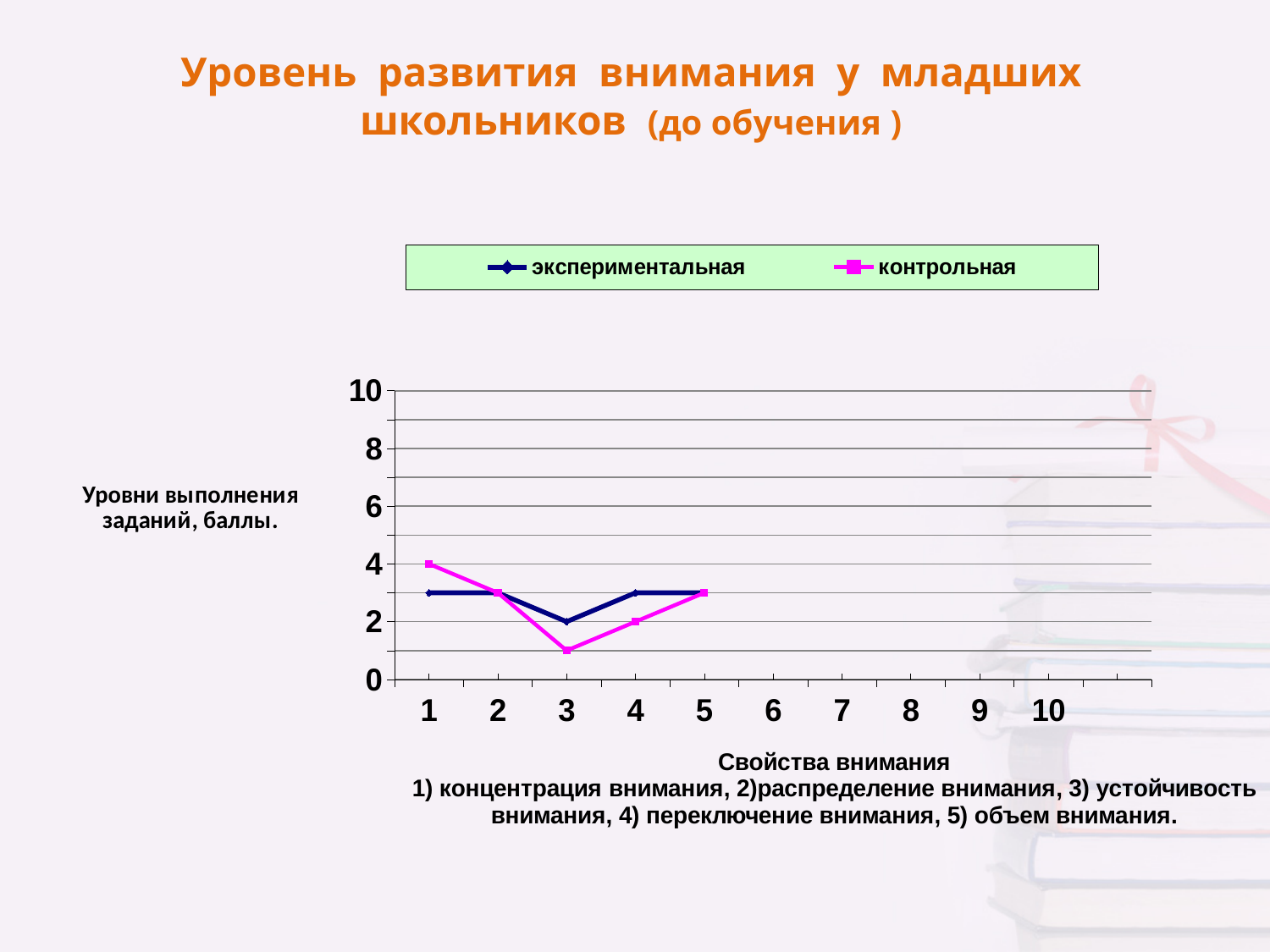
What is the value of the экспериментальная series at category 3? 2 What is the difference between the контрольная value at category 1 and the экспериментальная value at category 3? 2 What kind of chart is shown on the slide? line chart Does the контрольная series rise or fall from category 3 to category 5? rise At which category does the контрольная series reach its lowest value? 3 Is the value of the экспериментальная series at category 1 greater or less than 2? greater What is the value of the контрольная series at category 4? 2 What is the value of the контрольная series at category 1? 4 At category 3, which series has the higher value, экспериментальная or контрольная? экспериментальная Is the value of the контрольная series at category 3 greater or less than 2? less How many series does the legend list? 2 At which category does the контрольная series reach its highest value? 1